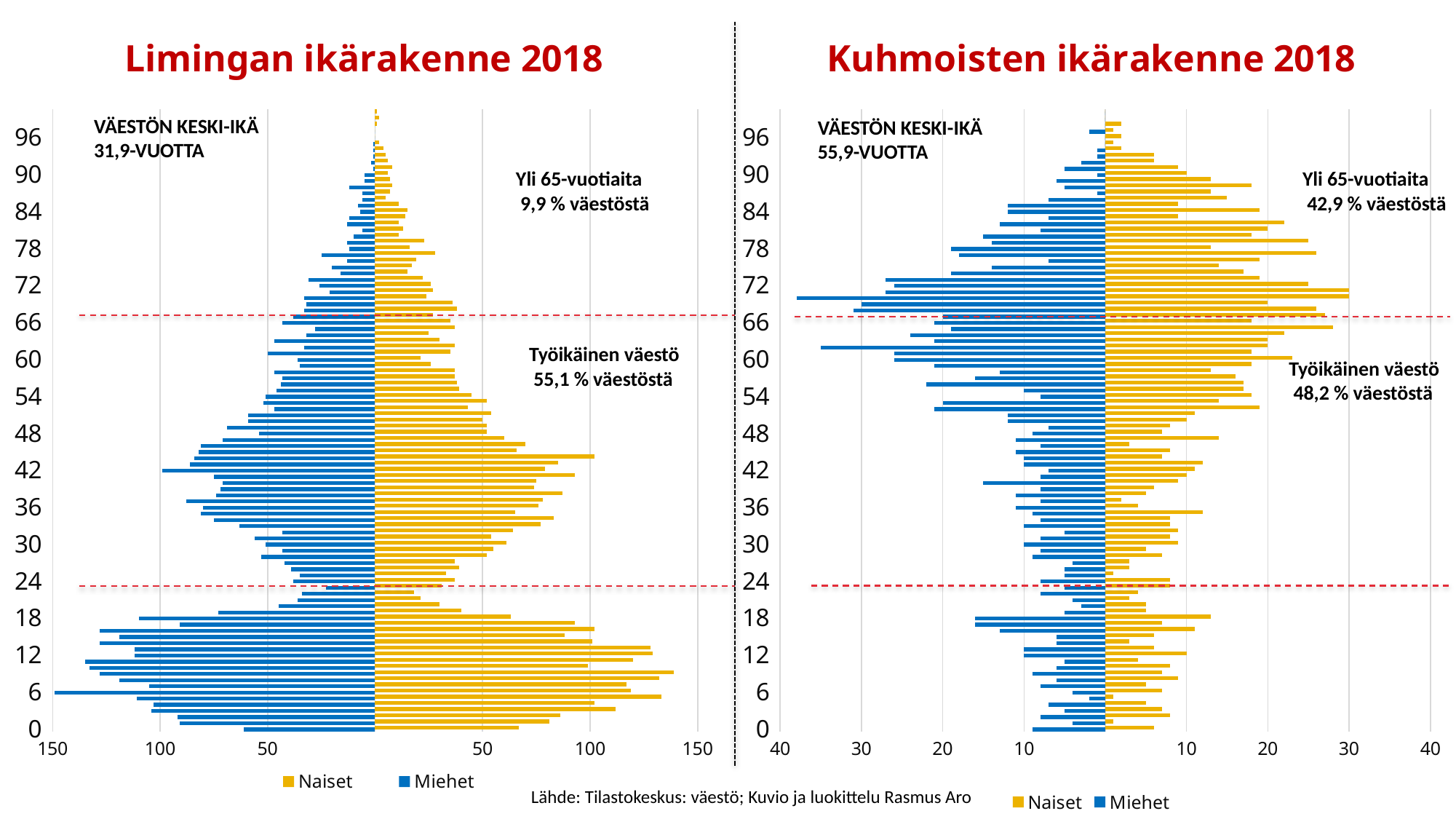
On the Limingan ikärakenne 2018 chart, is the Miehet value at age 6 greater or less than 100? greater On the Kuhmoisten ikärakenne 2018 chart, what share of the population is over 65 (yli 65-vuotiaita)? 42,9 % On the Limingan ikärakenne 2018 chart, what is the population's average age (väestön keski-ikä) shown? 31,9-vuotta Which chart shows a higher share of over-65-year-olds, Limingan ikärakenne 2018 or Kuhmoisten ikärakenne 2018? Kuhmoisten ikärakenne 2018 How many series does the legend of the Kuhmoisten ikärakenne 2018 chart list? 2 On the Limingan ikärakenne 2018 chart, is the Naiset value at age 90 greater or less than 50? less On the Limingan ikärakenne 2018 chart, what share of the population is working age (työikäinen väestö)? 55,1 % What are the two legend entries on the Limingan ikärakenne 2018 chart? Naiset, Miehet On the Kuhmoisten ikärakenne 2018 chart, is the Miehet value at age 60 greater or less than 30? less On the Kuhmoisten ikärakenne 2018 chart, what is the population's average age (väestön keski-ikä) shown? 55,9-vuotta What kind of chart is the Limingan ikärakenne 2018 chart? bar chart On the Kuhmoisten ikärakenne 2018 chart, which colour represents Miehet? blue